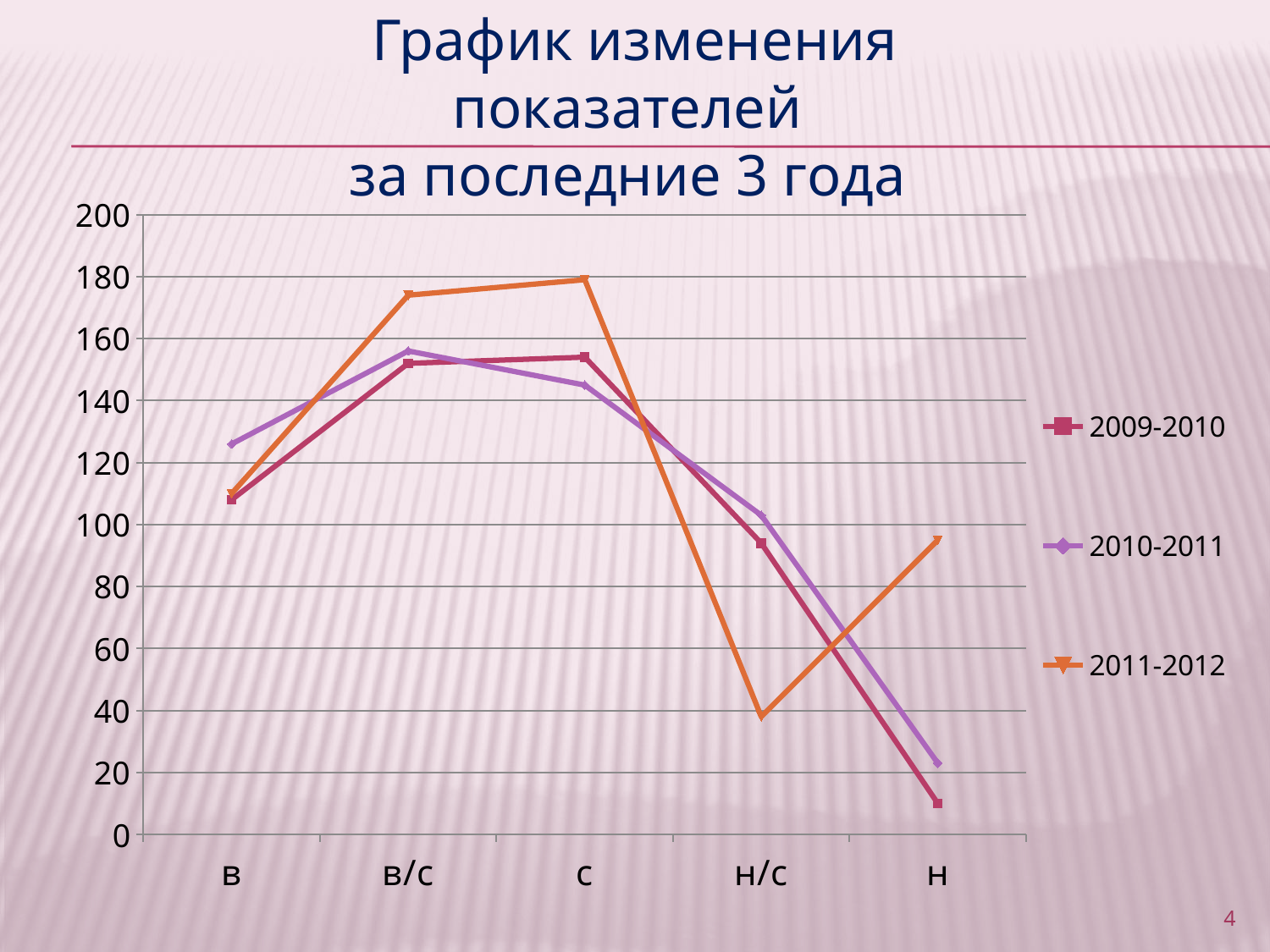
Is the value for 2009-2010 at н greater or less than 20? less What kind of chart is shown on the slide? line chart At category н, which series has the larger value: 2009-2010 or 2011-2012? 2011-2012 For the 2009-2010 series, which category has the lowest value? н How many categories are shown on the x axis? 5 Is the value for 2010-2011 at в greater or less than 120? greater How many series does the legend list? 3 Which series are listed in the legend? 2009-2010, 2010-2011, 2011-2012 For the 2011-2012 series, which category has the lowest value? н/с For the 2010-2011 series, which category has the lowest value? н Is the value for 2011-2012 at в/с greater or less than 160? greater At category н/с, which series has the larger value: 2010-2011 or 2011-2012? 2010-2011